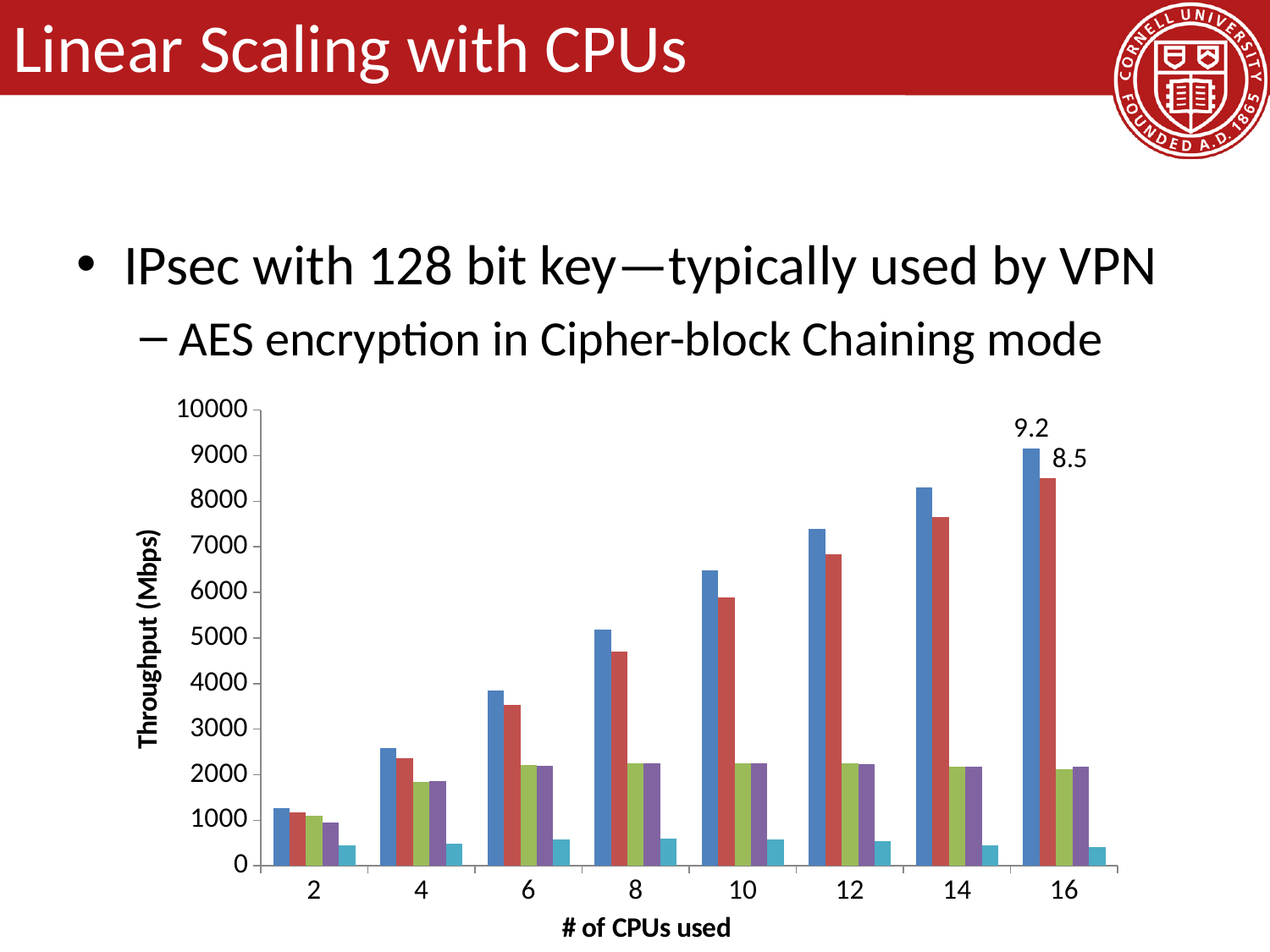
How many CPU-count categories are shown on the x axis? 8 What label is printed above the red bar at 16 CPUs? 8.5 What is the title of the y axis? Throughput (Mbps) At 16 CPUs, which is larger, the blue bar or the red bar? blue Does the blue series rise or fall as the number of CPUs increases? rise What label is printed above the blue bar at 16 CPUs? 9.2 What is the title of the x axis? # of CPUs used How many bars (series) are plotted for each CPU count? 5 Is the value of the blue bar at 10 CPUs greater or less than 6000? greater Is the value of the red bar at 8 CPUs greater or less than 5000? less What kind of chart is shown on the slide? bar chart At which CPU count does the blue series reach its highest value? 16